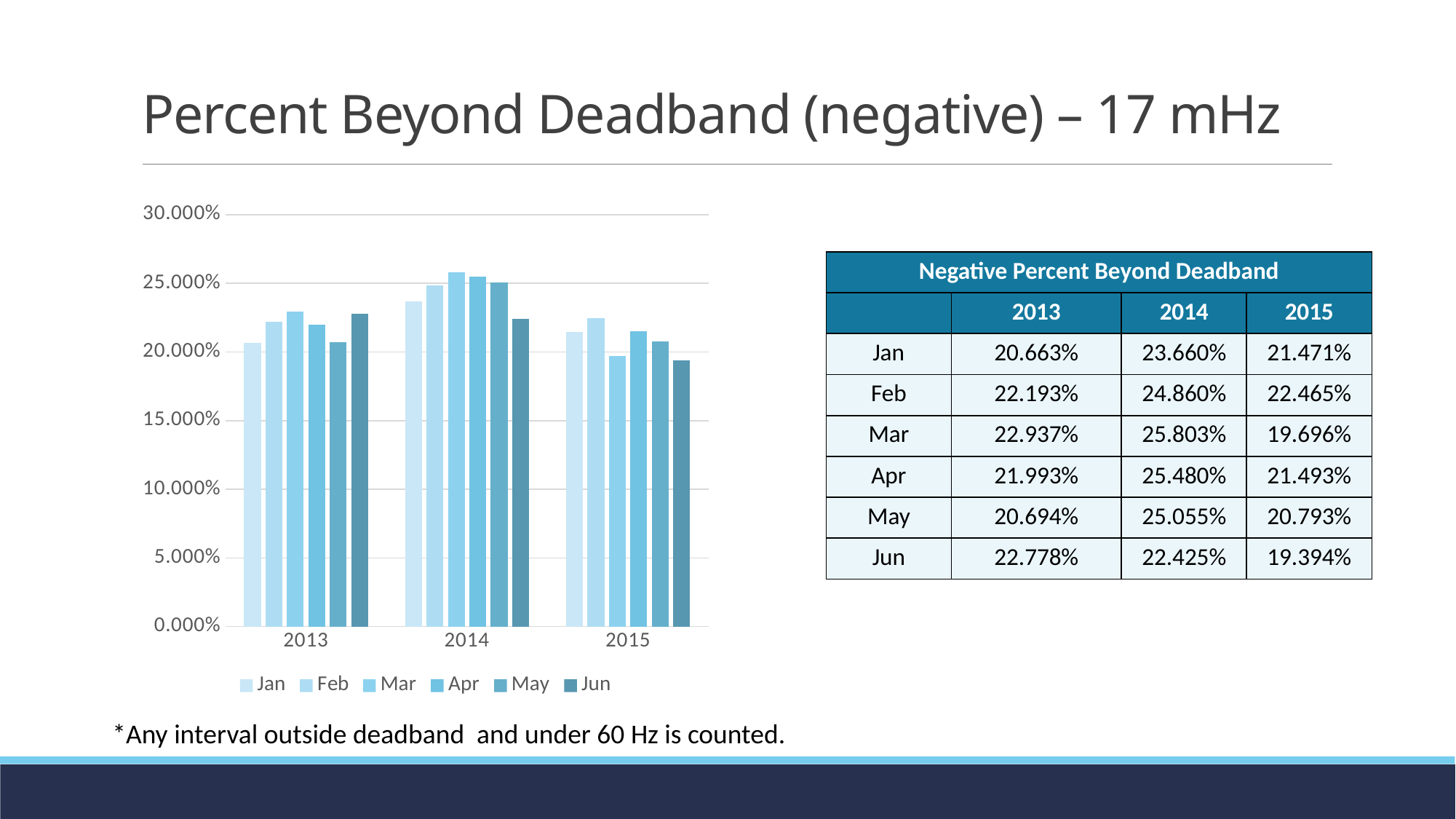
Which month has the highest value in 2014? Mar What is the value for Jan in 2013? 20.663% How many year categories are shown on the x axis of the chart? 3 What type of chart is shown on the slide? bar chart What is the difference between the Jan value in 2014 and the Jan value in 2013? 2.997% What is the value for Mar in 2014? 25.803% Is the value for Mar in 2014 greater or less than 25.000%? greater Does the Jan value rise or fall from 2014 to 2015? fall What is the value for Jun in 2015? 19.394% How many series does the chart legend list? 6 Which month has the lowest value in 2014? Jun Which is larger, the May value for 2014 or the May value for 2015? 2014